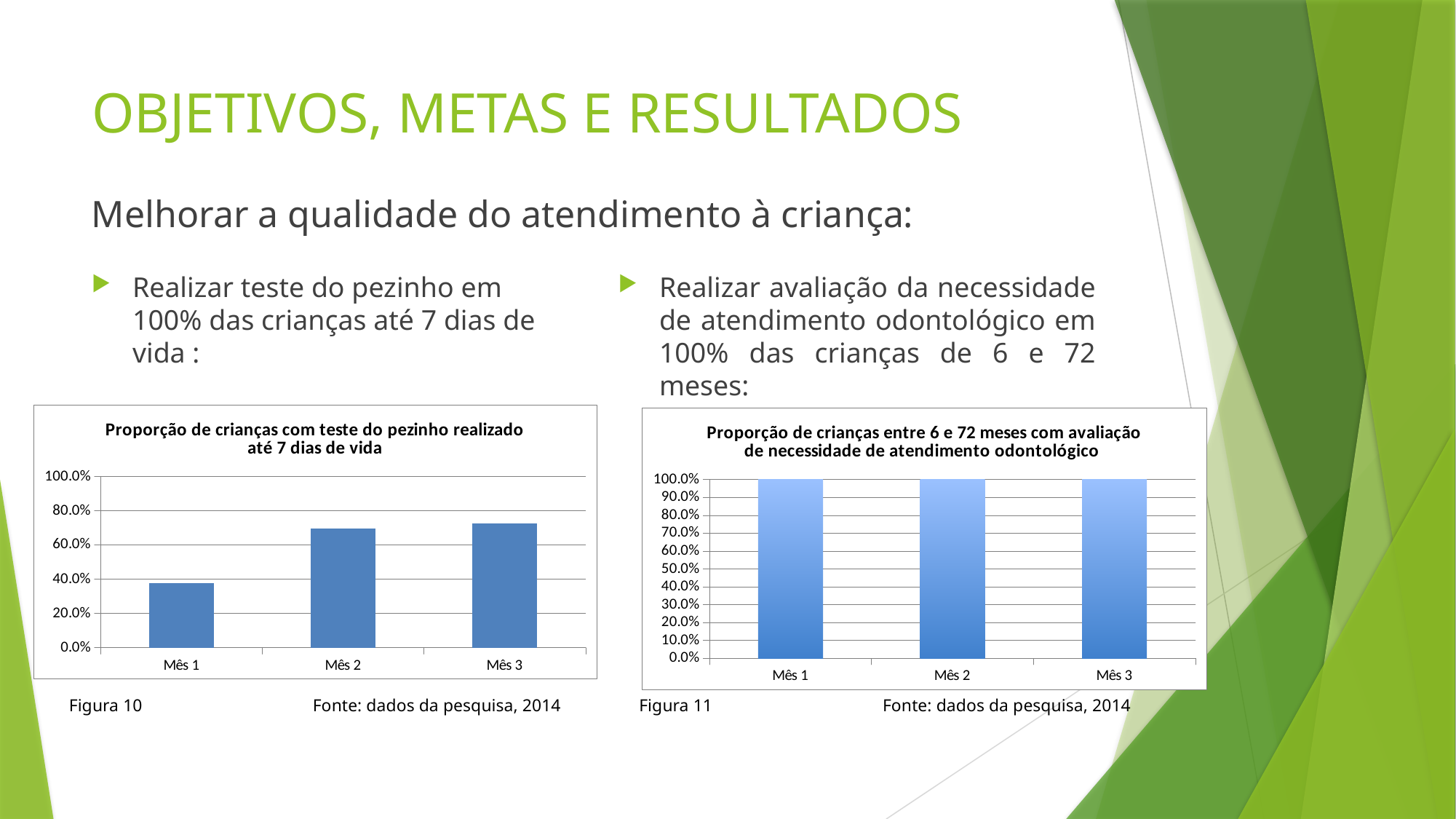
In the right chart (Figura 11), what is the value for Mês 1? 100.0% In the left chart (Figura 10), is the value for Mês 2 greater or less than 60.0%? greater In the right chart (Figura 11), what is the value for Mês 3? 100.0% In the left chart (Figura 10), is the value for Mês 3 greater or less than 80.0%? less How many categories are shown on the x axis of the left chart (Figura 10)? 3 In the left chart (Figura 10), which month has the lowest value? Mês 1 In the left chart (Figura 10), is the value for Mês 1 greater or less than 60.0%? less In the right chart (Figura 11), do the values rise, fall or stay the same from Mês 1 to Mês 3? Stay the same In the left chart (Figura 10), which is larger, the value for Mês 1 or the value for Mês 2? Mês 2 In the left chart (Figura 10), do the values rise or fall from Mês 1 to Mês 3? Rise What kind of chart is the left chart (Figura 10)? Bar chart What is the title of the right chart (Figura 11)? Proporção de crianças entre 6 e 72 meses com avaliação de necessidade de atendimento odontológico